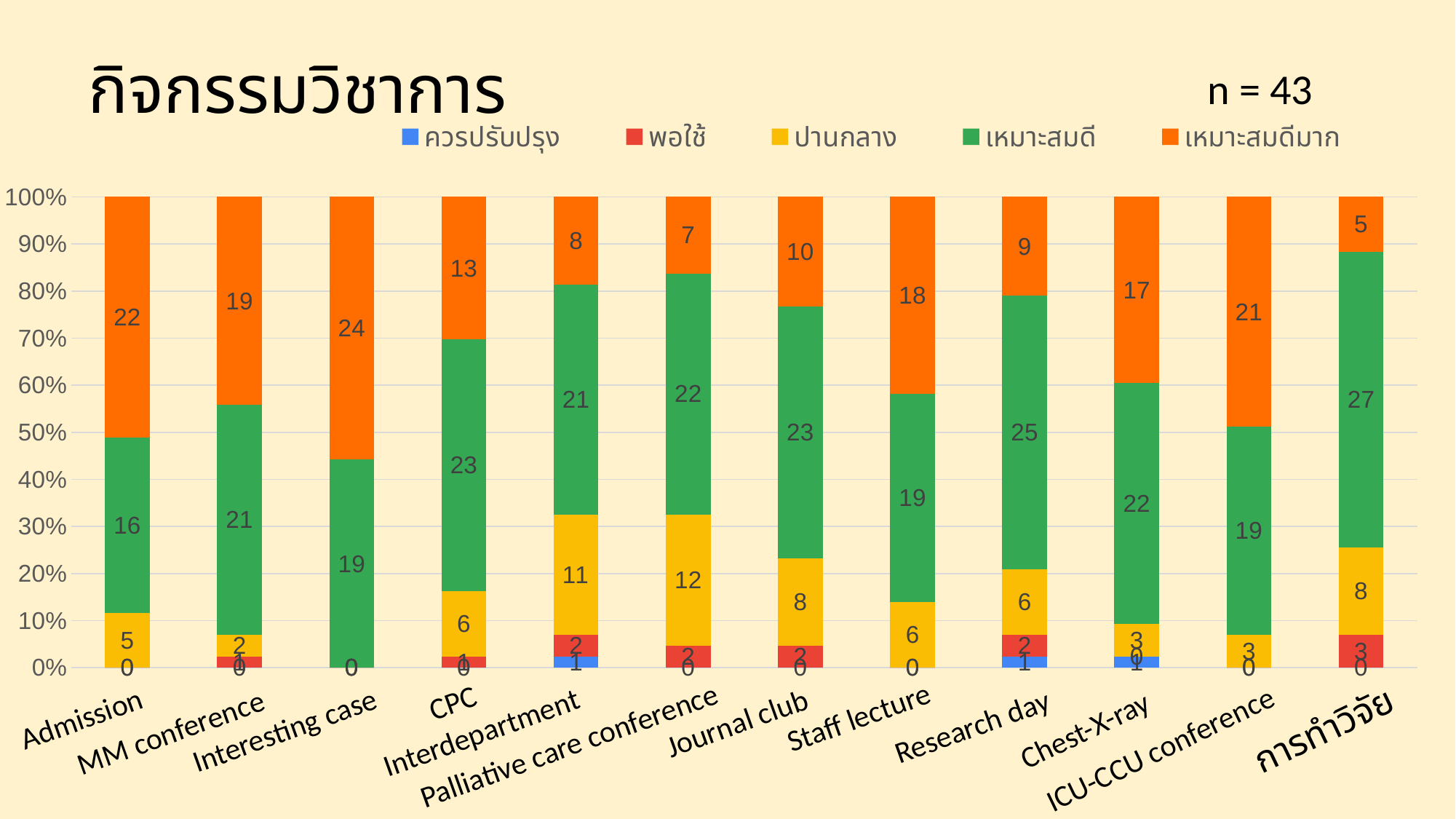
What is the value of ปานกลาง for Palliative care conference? 12 What kind of chart is shown on the slide? Stacked bar chart How many series does the legend list? 5 What is the value of เหมาะสมดี for การทำวิจัย? 27 Which category has the highest value for เหมาะสมดี? การทำวิจัย Which category has the lowest value for เหมาะสมดีมาก? การทำวิจัย What is the value of เหมาะสมดีมาก for Admission? 22 What is the difference between เหมาะสมดีมาก and เหมาะสมดี for Admission? 6 For CPC, which is larger: เหมาะสมดี or เหมาะสมดีมาก? เหมาะสมดี How many categories are shown on the x axis? 12 What is the value of เหมาะสมดีมาก for Staff lecture? 18 Which category has the highest value for เหมาะสมดีมาก? Interesting case